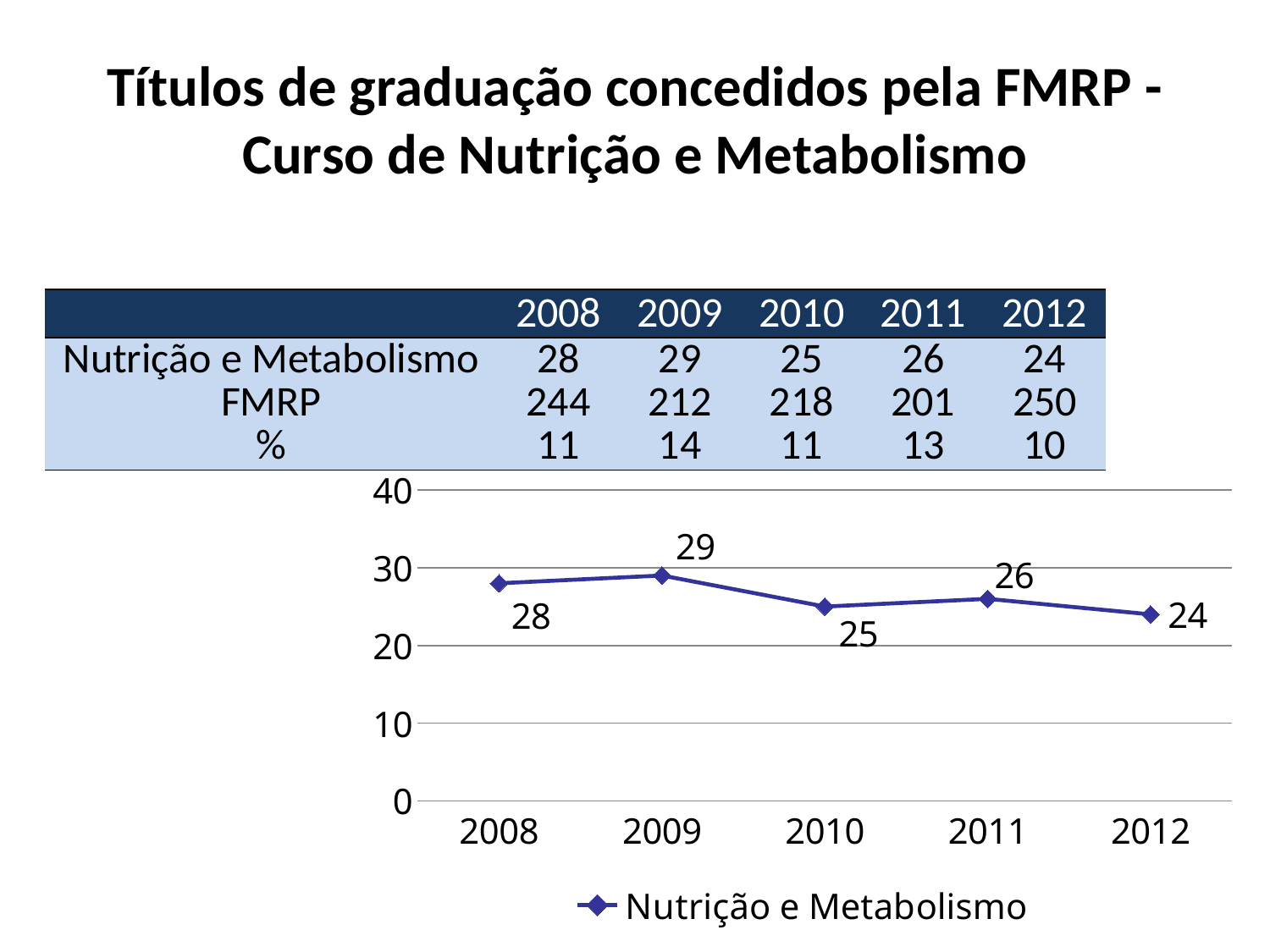
What is the value for 2010 in the line chart? 25 What kind of chart is shown on the slide? line chart Is the value for 2011 in the line chart greater or less than 30? less Which year has the highest value in the line chart? 2009 What is the difference between the values for 2009 and 2012 in the line chart? 5 What is the value for 2009 in the line chart? 29 What is the value for 2012 in the line chart? 24 How many years are plotted on the x axis of the line chart? 5 How many series does the legend of the line chart list? 1 Which is larger in the line chart, the value for 2008 or the value for 2010? 2008 Which year has the lowest value in the line chart? 2012 What series name is shown in the legend of the line chart? Nutrição e Metabolismo